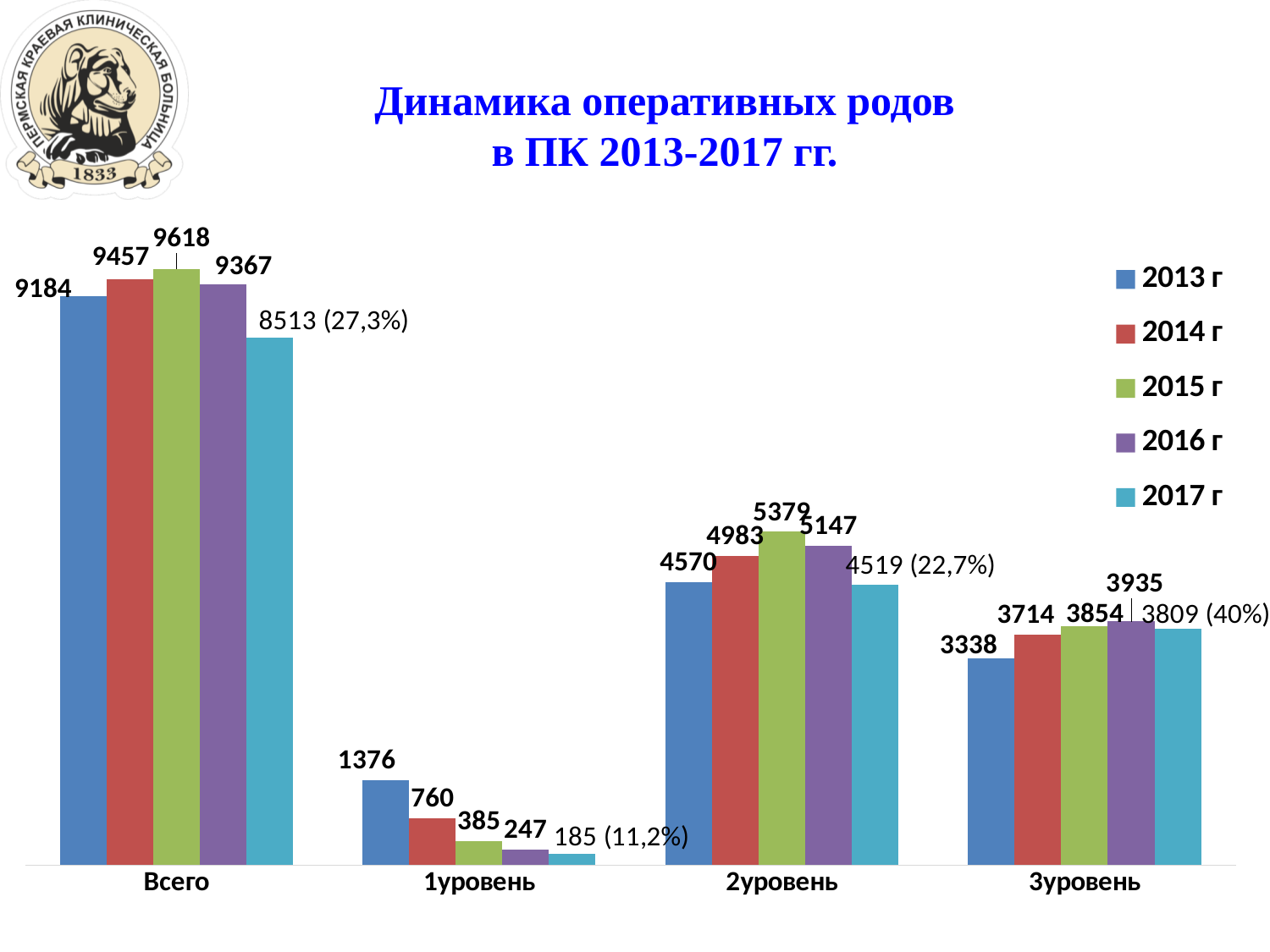
What is the value for 2016 г in the 3уровень category? 3935 What is the difference between the 2013 г and 2017 г values in the Всего category? 671 How many series does the legend list? 5 What is the value for 2015 г in the Всего category? 9618 Do the values in the 1уровень category rise or fall from 2013 г to 2017 г? fall What is the value for 2017 г in the 2уровень category? 4519 What is the value for 2013 г in the 1уровень category? 1376 What kind of chart is shown on the slide? bar chart Which is larger in the 2уровень category: the value for 2014 г or the value for 2016 г? 2016 г Which year has the lowest value in the 1уровень category? 2017 г Which year has the highest value in the Всего category? 2015 г How many categories are shown on the x axis? 4